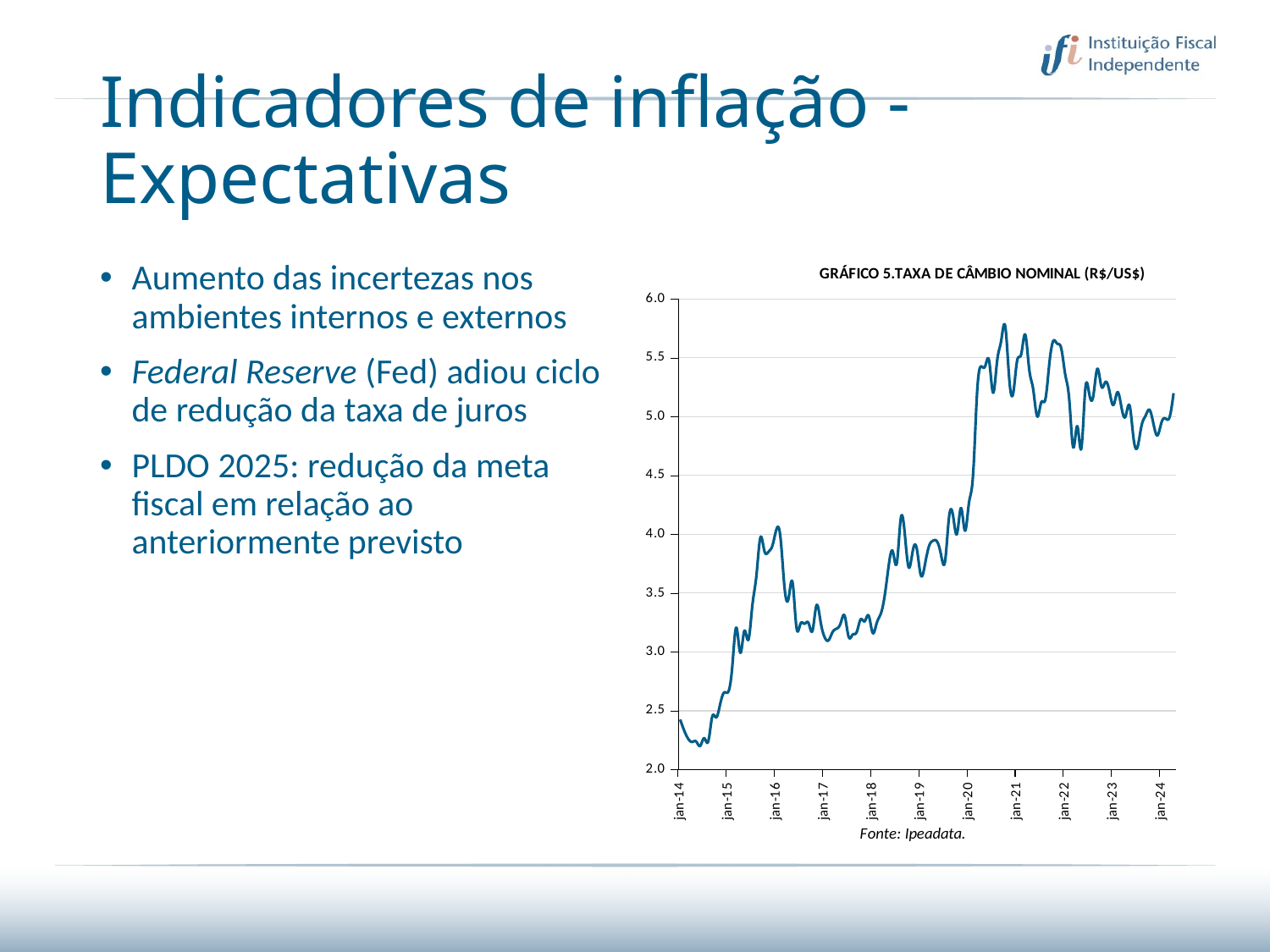
Is the value at jan-14 greater or less than 2.5? less Is the value at jan-20 greater or less than 4.5? less What source is cited below the chart? Ipeadata Is the highest point of the line greater or less than 5.5? greater What is the title of the chart on the slide? GRÁFICO 5.TAXA DE CÂMBIO NOMINAL (R$/US$) Overall, does the exchange rate rise or fall from jan-14 to jan-24? rise What kind of chart is shown on the slide? line chart Which is larger, the value at jan-14 or the value at jan-24? jan-24 How many year labels are shown on the x axis? 11